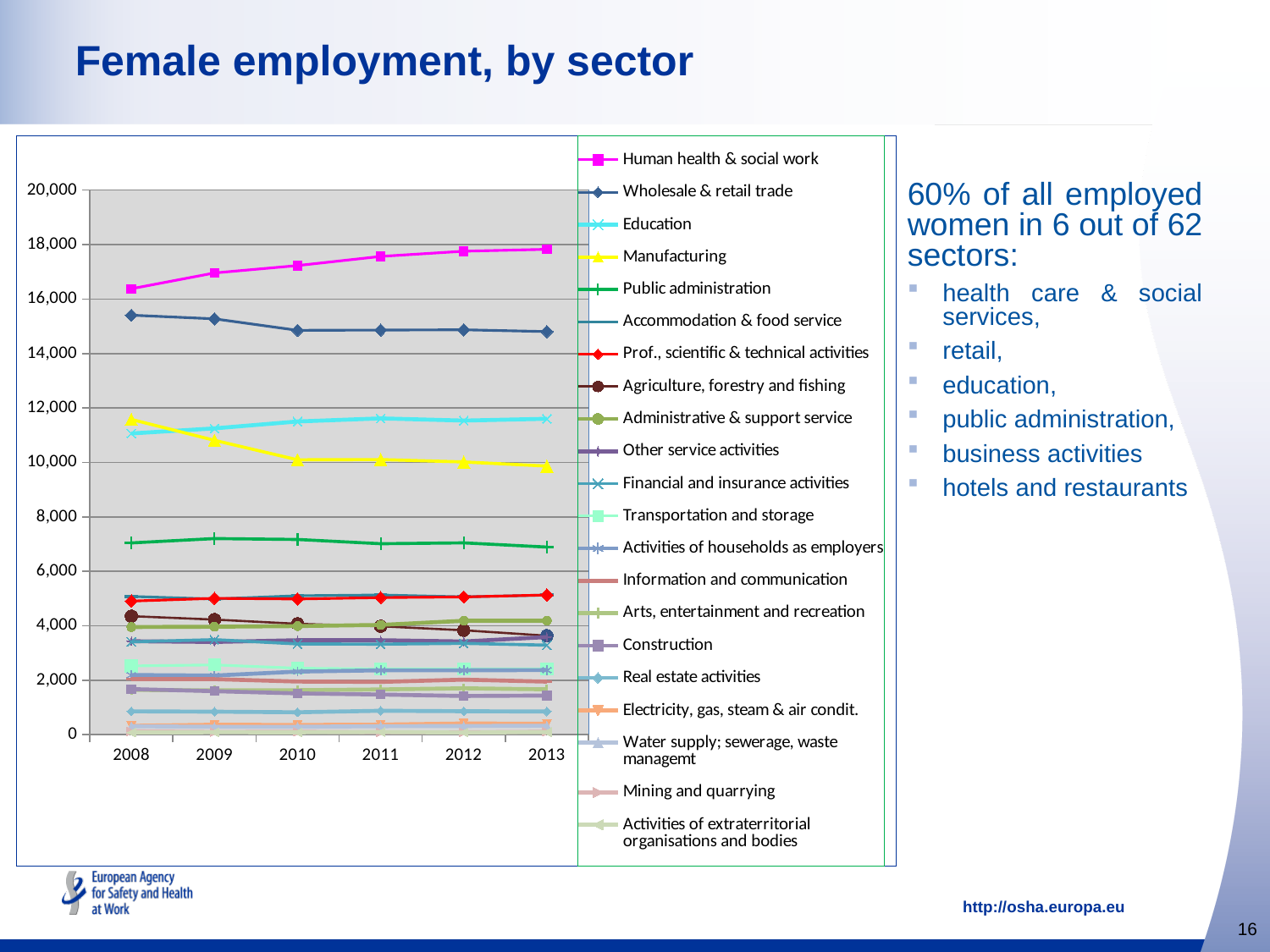
Does female employment in Human health & social work rise or fall from 2008 to 2013? rise What kind of chart is shown on the slide? line chart Is the value for Human health & social work in 2013 greater or less than 16,000? greater Which sector has the highest female employment in 2013? Human health & social work How many series does the chart's legend list? 21 How many years are plotted along the x axis of the chart? 6 Which sector has the second highest female employment in 2013? Wholesale & retail trade Is the value for Public administration in 2013 greater or less than 8,000? less Is the value for Wholesale & retail trade in 2013 greater or less than 16,000? less In 2013, which is larger: female employment in Education or in Manufacturing? Education What is the title of the slide containing the chart? Female employment, by sector Does female employment in Manufacturing rise or fall from 2008 to 2013? fall